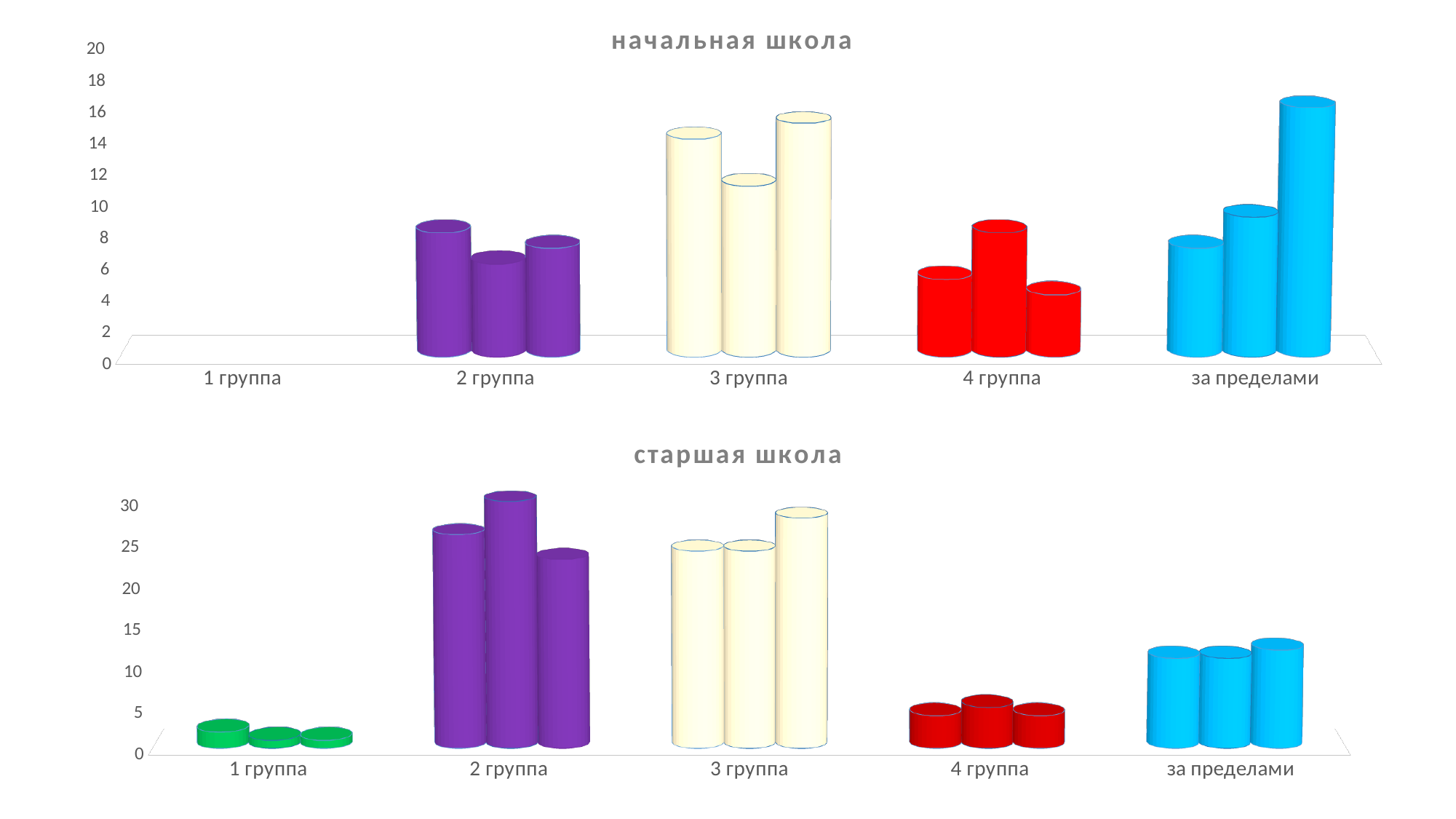
In the 'старшая школа' chart, are the values for '2 группа' greater or less than 20? greater What is the title of the top chart on the slide? начальная школа In the 'начальная школа' chart, are the values for '4 группа' greater or less than 10? less In the 'старшая школа' chart, are the values for '1 группа' greater or less than 5? less What is the title of the bottom chart on the slide? старшая школа In the 'начальная школа' chart, which category has larger values, '3 группа' or '4 группа'? 3 группа In the 'старшая школа' chart, which category has the lowest values? 1 группа How many categories are shown on the x axis of the 'старшая школа' chart? 5 What type of chart is the 'начальная школа' chart? bar chart In the 'старшая школа' chart, which category has larger values, '2 группа' or '4 группа'? 2 группа